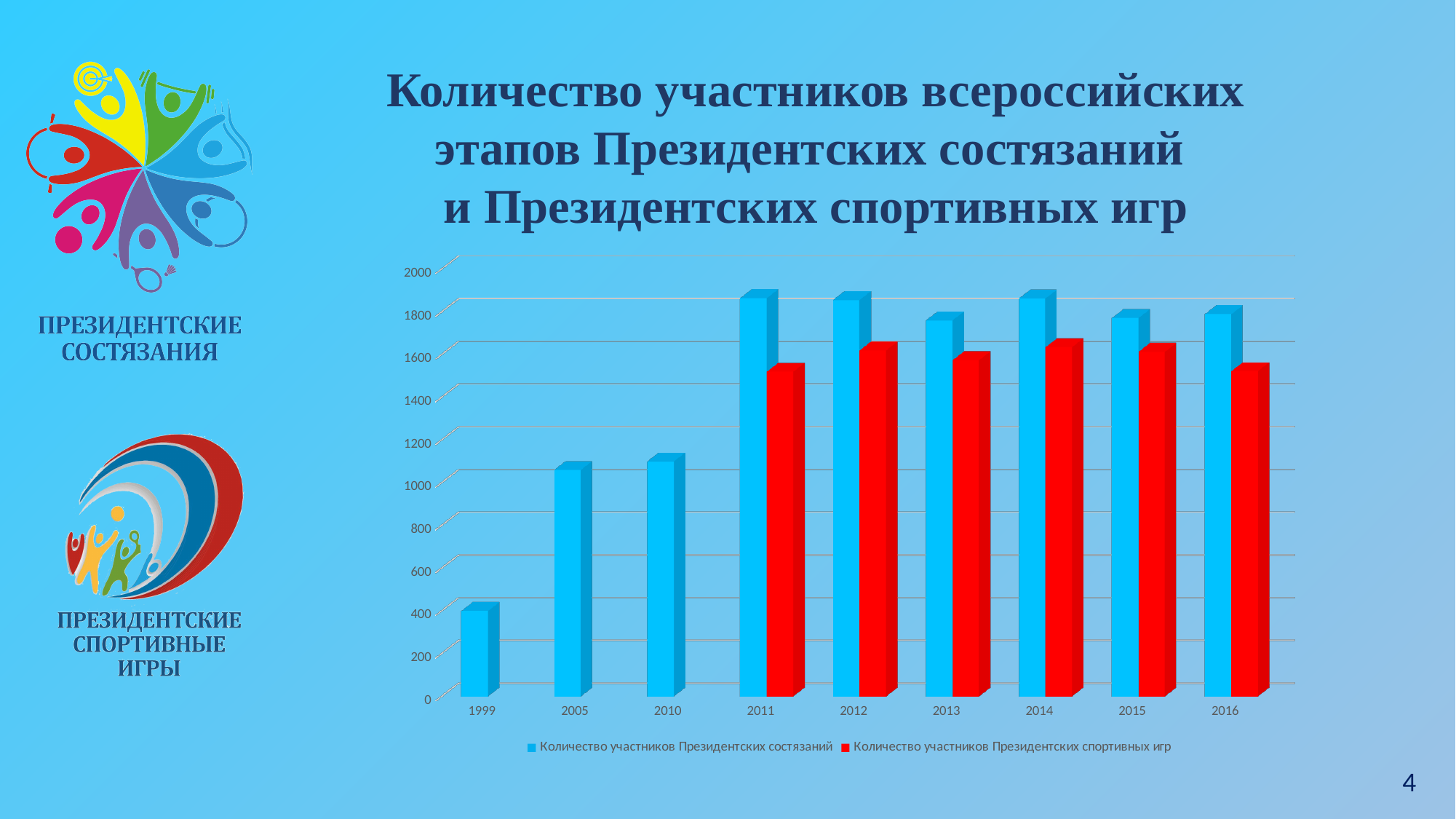
Does the value for Количество участников Президентских состязаний rise or fall from 1999 to 2011? rise For how many years does the chart show a value for Количество участников Президентских спортивных игр? 6 Is the value for Количество участников Президентских состязаний in 1999 greater or less than 600? less Is the value for Количество участников Президентских состязаний in 2011 greater or less than 1800? greater Is the value for Количество участников Президентских состязаний in 2005 greater or less than 1000? greater In 2011, which series has the larger value: Количество участников Президентских состязаний or Количество участников Президентских спортивных игр? Количество участников Президентских состязаний How many series does the chart legend list? 2 Which year has the lowest value for Количество участников Президентских состязаний? 1999 How many years are shown on the x axis of the chart? 9 What kind of chart is shown on the slide? bar chart